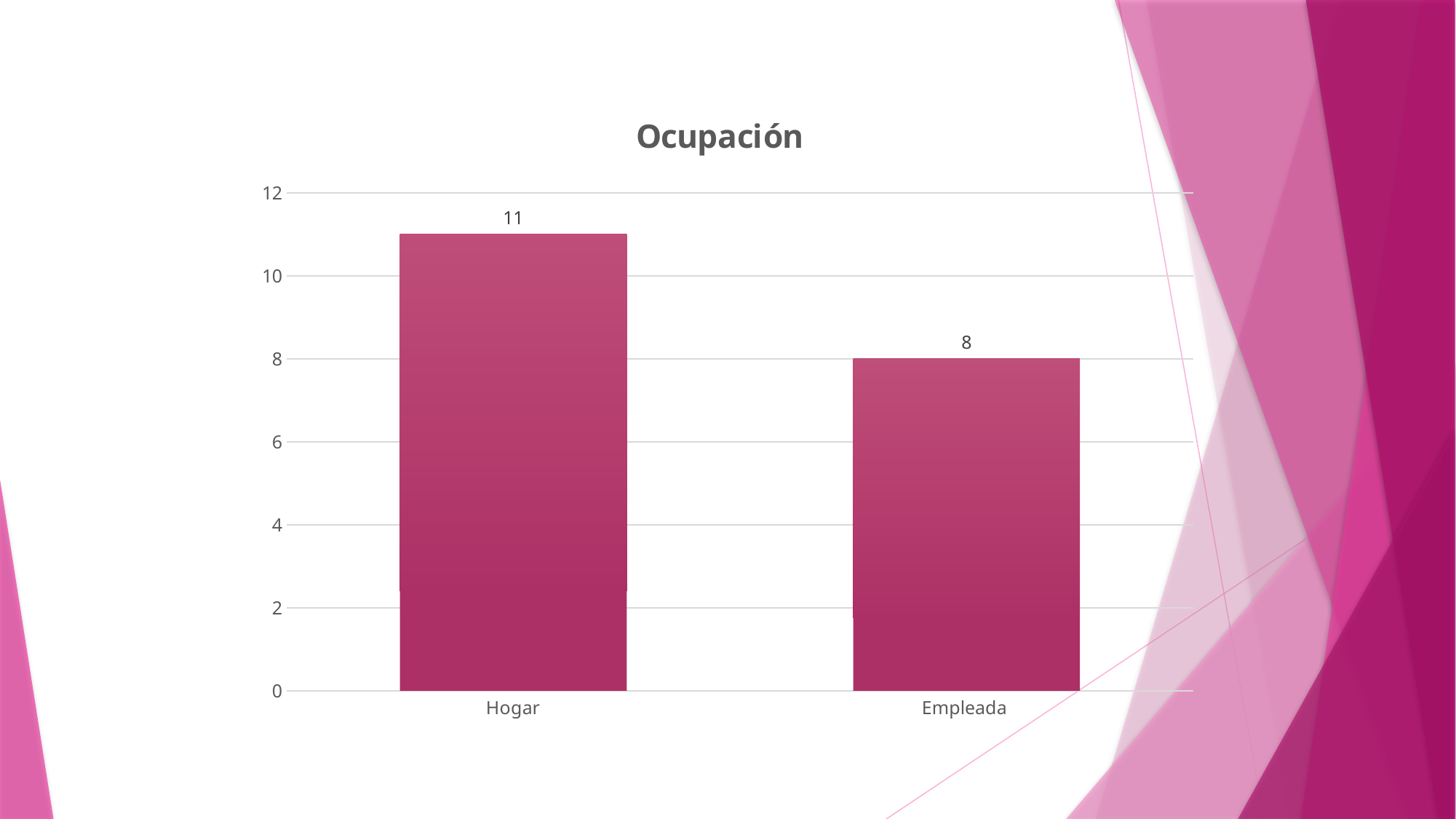
What kind of chart is shown on the slide? bar chart Which is larger, the value for Hogar or the value for Empleada? Hogar What is the value for Hogar? 11 Is the value for Empleada greater or less than 10? less Which category has the lowest value? Empleada What is the highest value shown on the vertical axis? 12 What is the difference between the values for Hogar and Empleada? 3 What is the title of the chart? Ocupación How many categories are shown on the chart? 2 Which category has the highest value? Hogar What is the value for Empleada? 8 Is the value for Hogar greater or less than 10? greater